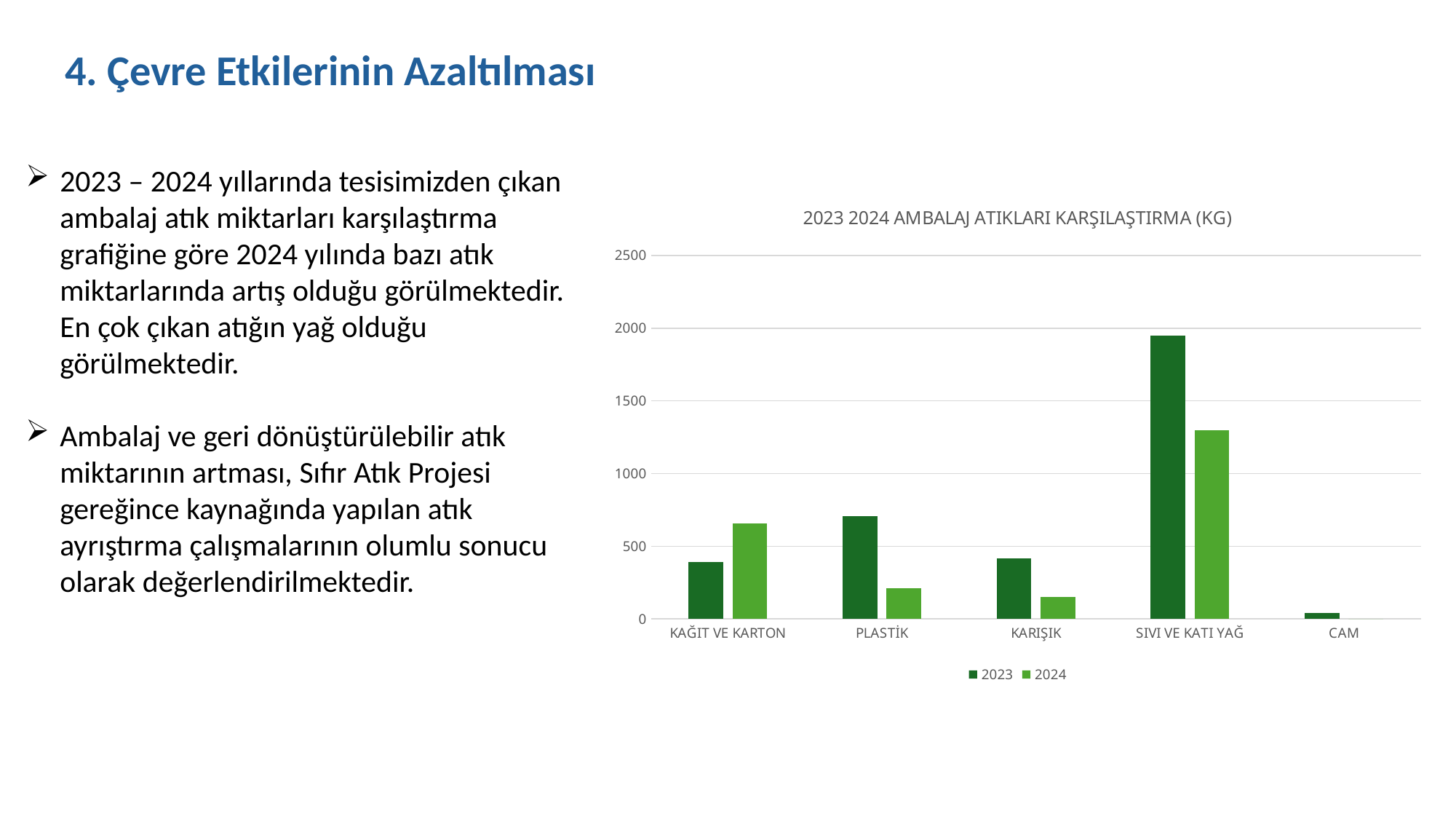
For PLASTİK, which year has the larger value, 2023 or 2024? 2023 How many series does the chart legend list? 2 What is the title of the chart? 2023 2024 AMBALAJ ATIKLARI KARŞILAŞTIRMA (KG) Is the 2024 value for PLASTİK greater or less than 500? less For KAĞIT VE KARTON, which year has the larger value, 2023 or 2024? 2024 Which category has the lowest value for 2023? CAM How many categories are shown on the x axis of the chart? 5 What kind of chart is shown on the slide? bar chart Which category has the highest value for 2023? SIVI VE KATI YAĞ Is the 2023 value for SIVI VE KATI YAĞ greater or less than 1500? greater Which category has the highest value for 2024? SIVI VE KATI YAĞ Is the 2024 value for SIVI VE KATI YAĞ greater or less than 1000? greater